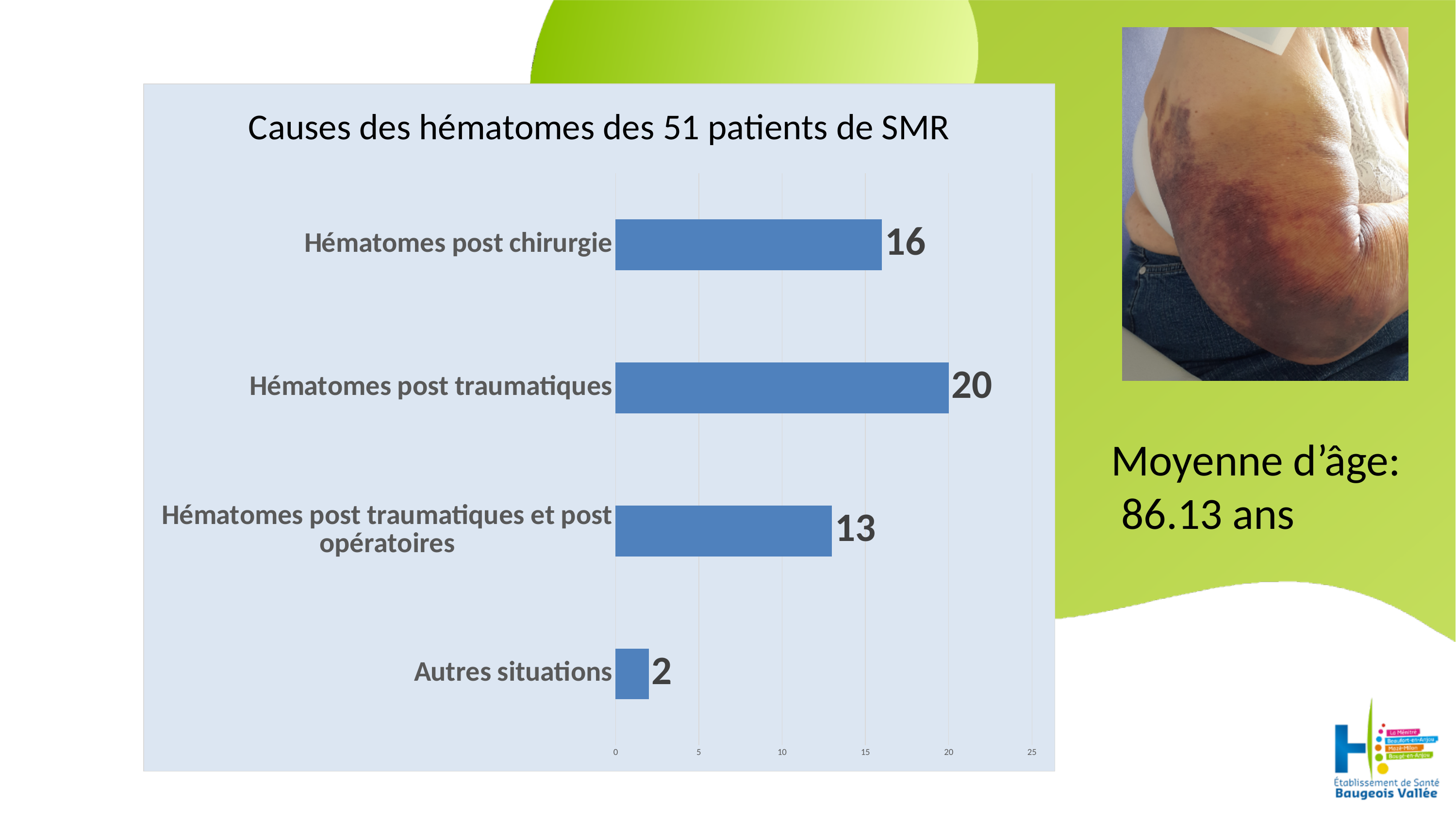
Which is larger, Hématomes post chirurgie or Hématomes post traumatiques et post opératoires? Hématomes post chirurgie Which category has the lowest value? Autres situations Is the value for Hématomes post traumatiques et post opératoires greater or less than 10? greater Which category has the highest value? Hématomes post traumatiques What is the value for Hématomes post traumatiques? 20 What is the title of the chart? Causes des hématomes des 51 patients de SMR How many categories are shown in the chart? 4 What is the difference between Hématomes post traumatiques and Hématomes post chirurgie? 4 What kind of chart is shown? Bar chart What is the value for Hématomes post traumatiques et post opératoires? 13 What is the value for Autres situations? 2 What is the value for Hématomes post chirurgie? 16